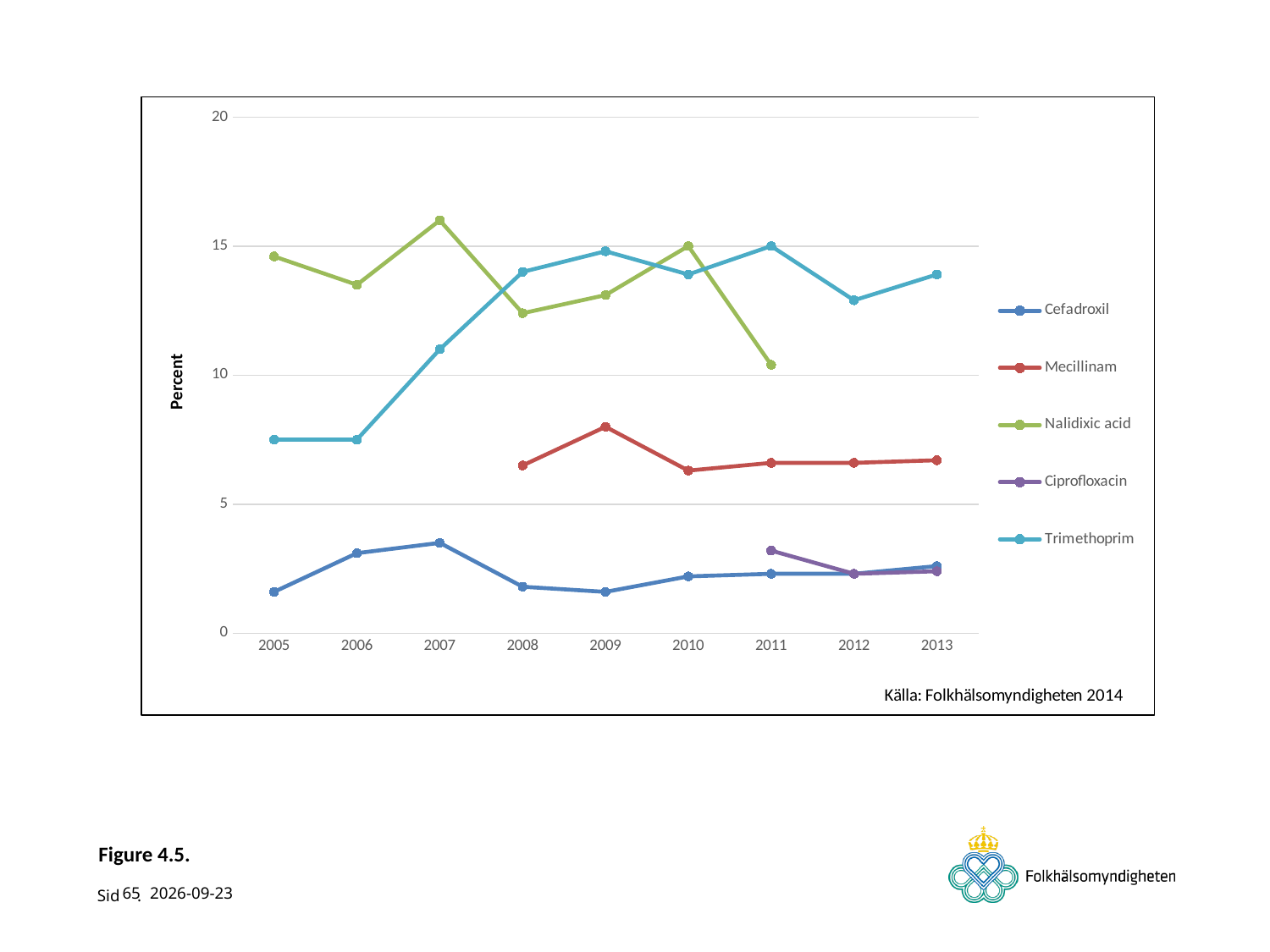
Is the value for Nalidixic acid in 2007 greater or less than 15? greater Which series has the highest value in 2007? Nalidixic acid What is the label on the y axis? Percent Which series has the lowest value in 2009? Cefadroxil Does the Trimethoprim line rise or fall from 2005 to 2007? Rise Is the value for Cefadroxil in 2005 greater or less than 5? less How many years are shown on the x axis? 9 Is the value for Trimethoprim in 2005 greater or less than 10? less What kind of chart is shown on the slide? Line chart How many series does the legend list? 5 In 2013, which is larger: Trimethoprim or Mecillinam? Trimethoprim